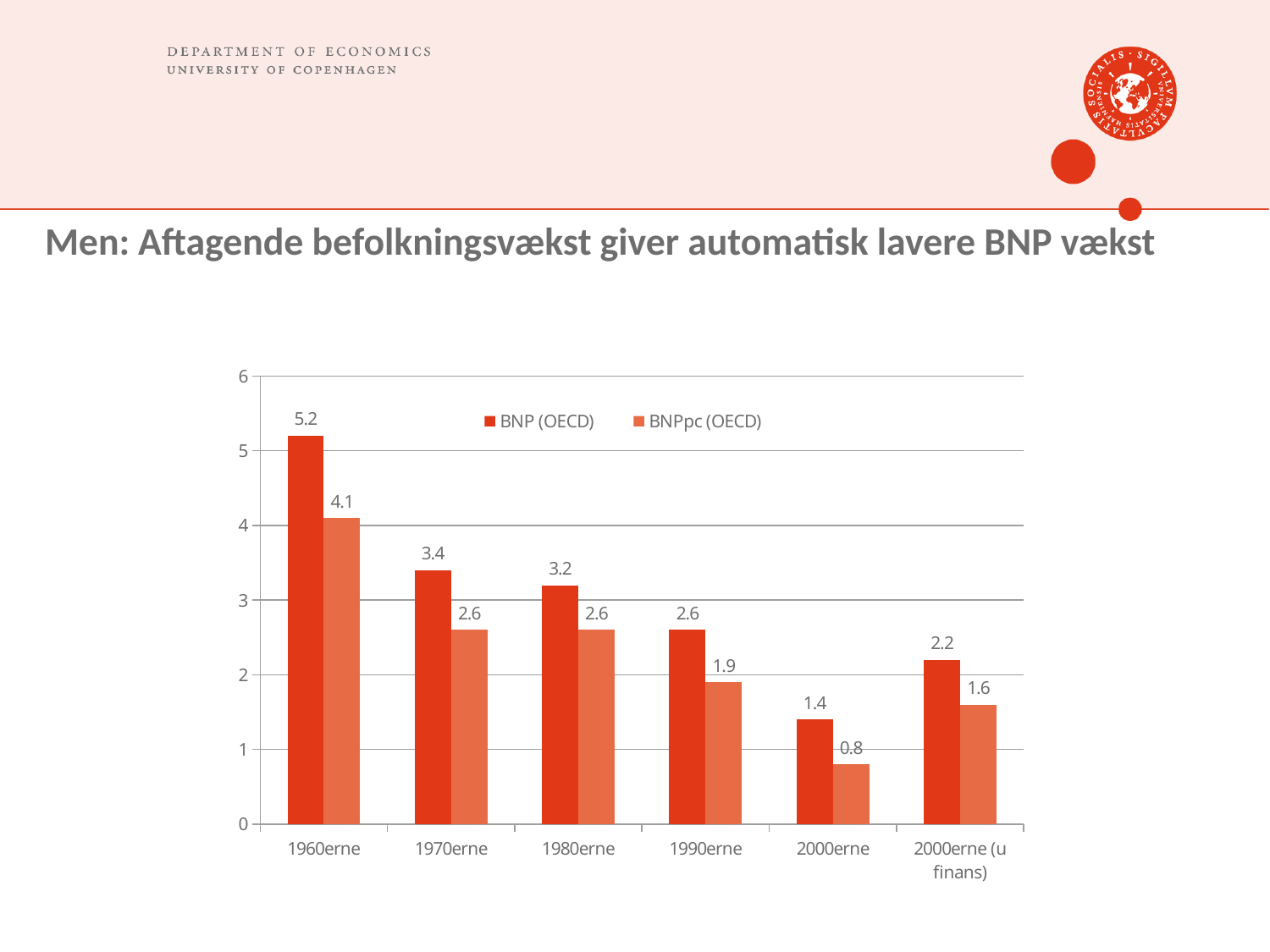
What is the BNPpc (OECD) value for 2000erne? 0.8 How many categories are shown on the x axis? 6 Which category has the lowest BNPpc (OECD) value? 2000erne What is the BNP (OECD) value for 1960erne? 5.2 Which category has the highest BNP (OECD) value? 1960erne Which is larger: the BNP (OECD) value for 1980erne or the BNP (OECD) value for 1990erne? 1980erne How many series does the legend list? 2 What is the difference between the BNP (OECD) values for 1970erne and 2000erne? 2 What is the difference between the BNP (OECD) and BNPpc (OECD) values for 1960erne? 1.1 Do the BNP (OECD) values rise or fall from 1960erne to 2000erne? Fall What kind of chart is shown on the slide? Bar chart What is the BNPpc (OECD) value for 1990erne? 1.9